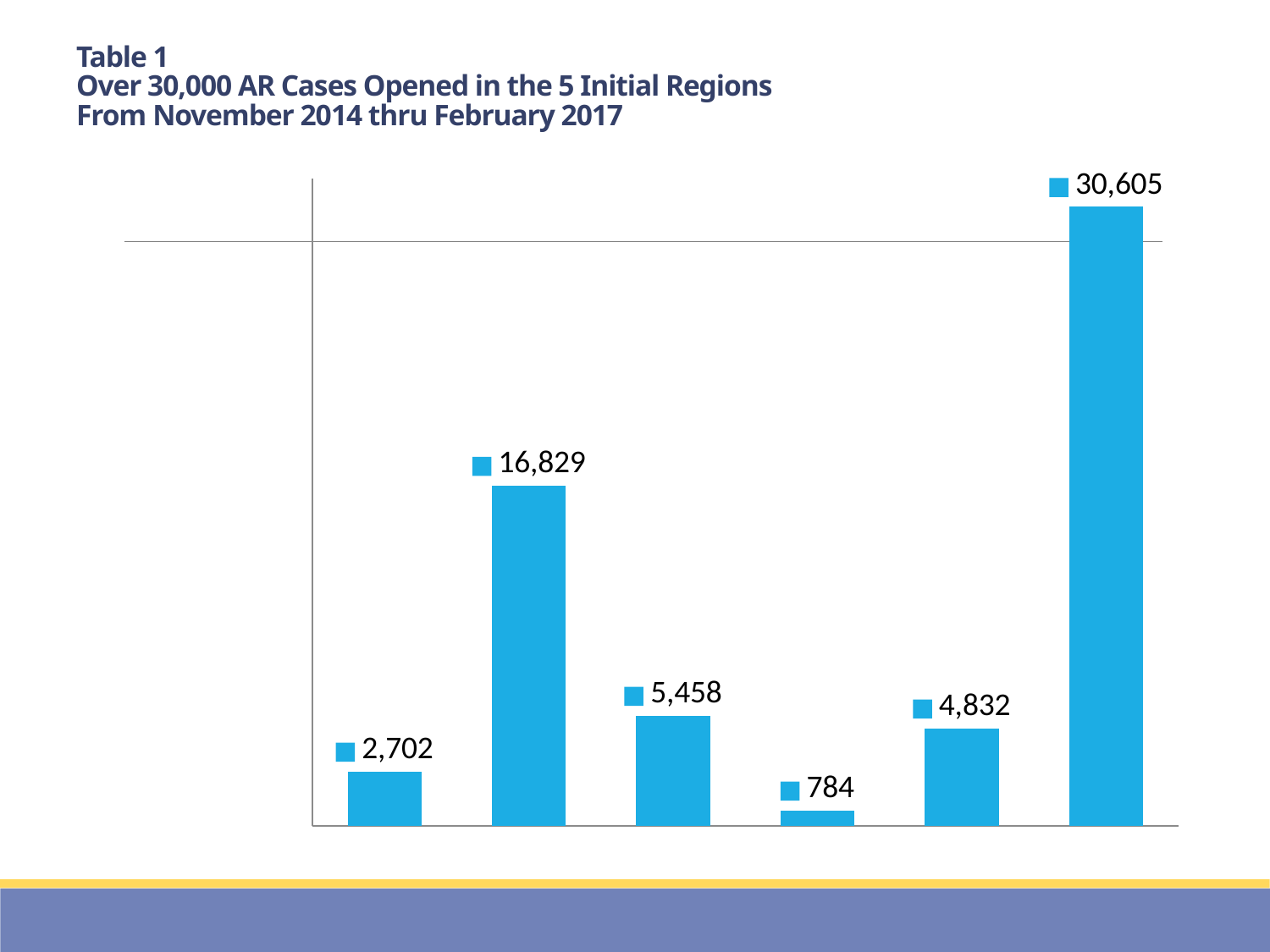
Which bar has the lowest value? the fourth bar (784) What is the value shown on the last (rightmost) bar? 30,605 Which is larger, the third bar or the fifth bar? the third bar (5,458) Which bar has the highest value? the rightmost bar (30,605) How many bars are plotted in the chart? 6 What is the value shown on the fourth bar from the left? 784 What is the difference between the rightmost bar (30,605) and the second bar (16,829)? 13,776 What is the value shown on the second bar from the left? 16,829 What is the value shown on the first (leftmost) bar? 2,702 What is the value shown on the third bar from the left? 5,458 What kind of chart is shown on the slide? bar chart What is the value shown on the fifth bar from the left? 4,832